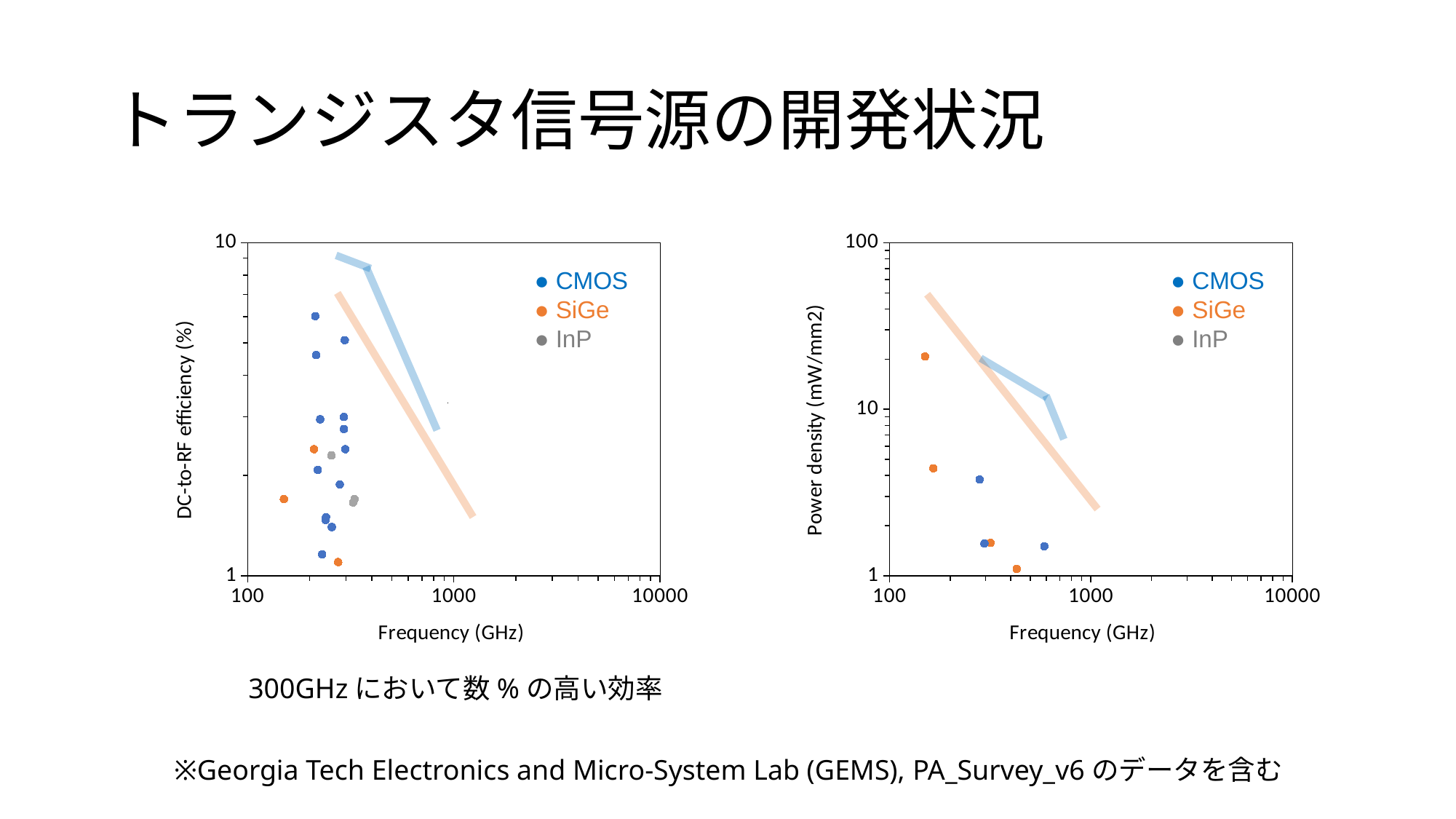
In the left chart, is the highest CMOS efficiency value greater or less than 10? less How many series does the legend of the left chart list? 3 In the left chart, which series is shown in orange? SiGe What kind of chart is the right chart (Power density vs Frequency)? scatter chart How many series does the legend of the right chart list? 3 In the right chart, is the power density of the CMOS point near 280 GHz greater or less than 10? less In the right chart, is the power density of the SiGe point near 150 GHz greater or less than 10? greater What is the y-axis label of the right chart? Power density (mW/mm2) In the right chart, which series has the point with the highest power density? SiGe How many SiGe points are plotted in the right chart? 4 In the left chart, which series has the point with the highest DC-to-RF efficiency? CMOS What kind of chart is the left chart (DC-to-RF efficiency vs Frequency)? scatter chart